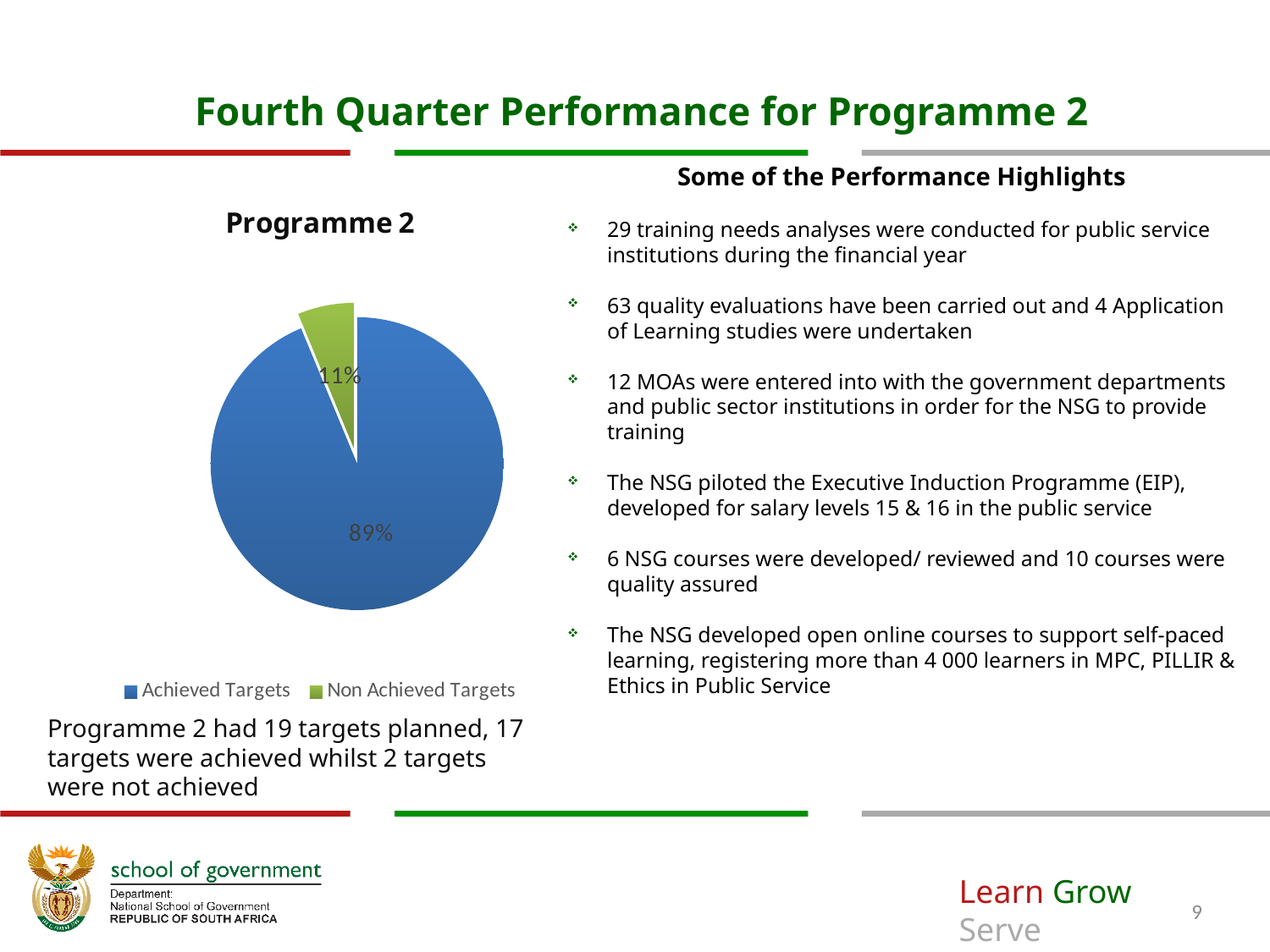
What is the difference in percentage points between Achieved Targets and Non Achieved Targets? 78 Which is larger, Achieved Targets or Non Achieved Targets? Achieved Targets How many slices does the pie chart have? 2 What is the chart's title? Programme 2 What percentage of the pie is Non Achieved Targets? 11% What kind of chart is shown on the slide? pie chart Which slice is the largest? Achieved Targets What colour is the Non Achieved Targets slice? green What percentage of the pie is Achieved Targets? 89% Which slice is the smallest? Non Achieved Targets How many entries does the legend list? 2